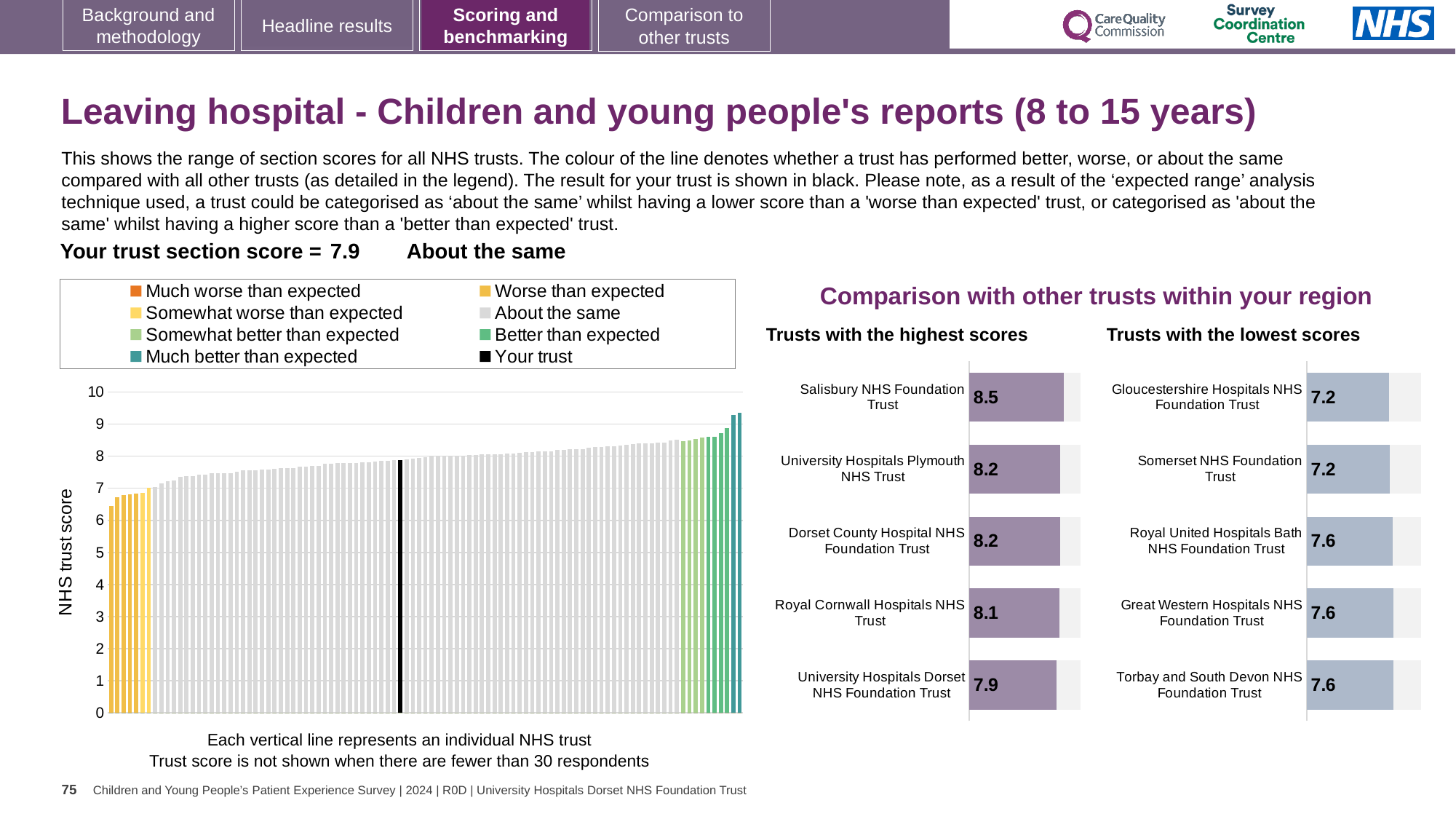
What kind of chart is the large chart on the left showing the range of section scores for all NHS trusts? Bar chart In the 'Trusts with the highest scores' chart, what is the score for Salisbury NHS Foundation Trust? 8.5 In the 'Trusts with the lowest scores' chart, how many trusts are listed? 5 In the 'Trusts with the lowest scores' chart, what is the score for Royal United Hospitals Bath NHS Foundation Trust? 7.6 How many entries does the legend of the large chart on the left list? 8 In the 'Trusts with the highest scores' chart, which trust has the highest score? Salisbury NHS Foundation Trust In the 'Trusts with the highest scores' chart, what is the difference between the scores of Salisbury NHS Foundation Trust and University Hospitals Dorset NHS Foundation Trust? 0.6 In the large chart on the left, do the trust scores rise or fall from left to right? Rise Which is larger: the score for Salisbury NHS Foundation Trust in the highest scores chart or the score for Torbay and South Devon NHS Foundation Trust in the lowest scores chart? Salisbury NHS Foundation Trust In the 'Trusts with the lowest scores' chart, what is the score for Gloucestershire Hospitals NHS Foundation Trust? 7.2 In the 'Trusts with the lowest scores' chart, what is the difference between the scores of Royal United Hospitals Bath NHS Foundation Trust and Somerset NHS Foundation Trust? 0.4 In the 'Trusts with the highest scores' chart, what is the score for University Hospitals Dorset NHS Foundation Trust? 7.9